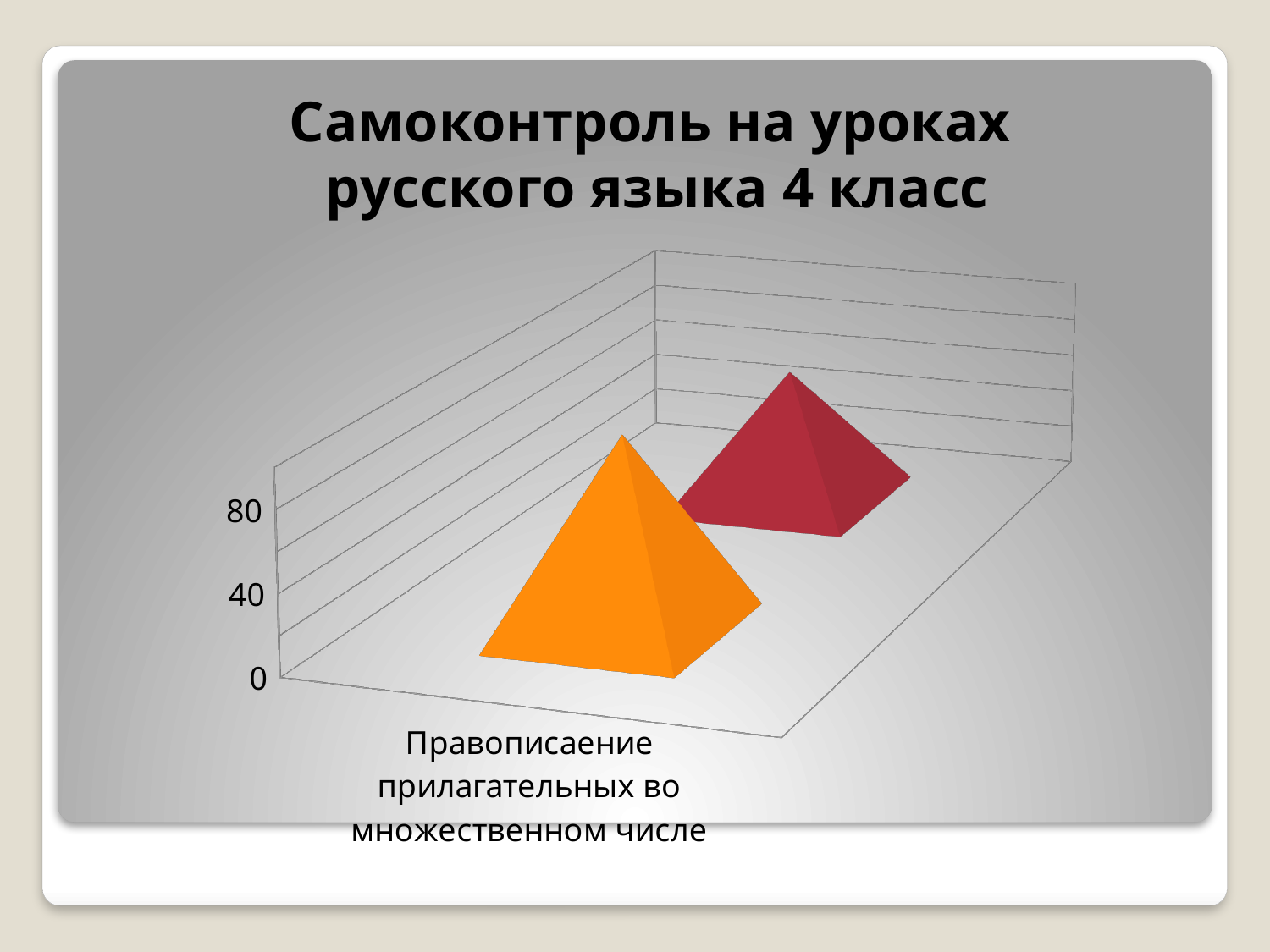
Which bar is taller, the orange one or the red one? the orange one What is the title of the slide with the chart? Самоконтроль на уроках русского языка 4 класс Is the value of the red bar greater or less than 40? greater What kind of chart is shown on the slide? bar chart What is the category label shown on the x axis of the chart? Правописаение прилагательных во множественном числе How many pyramid-shaped bars are plotted on the chart? 2 How many categories are shown on the x axis of the chart? 1 Is the value of the orange bar greater or less than 40? greater What is the highest tick value labelled on the vertical axis? 80